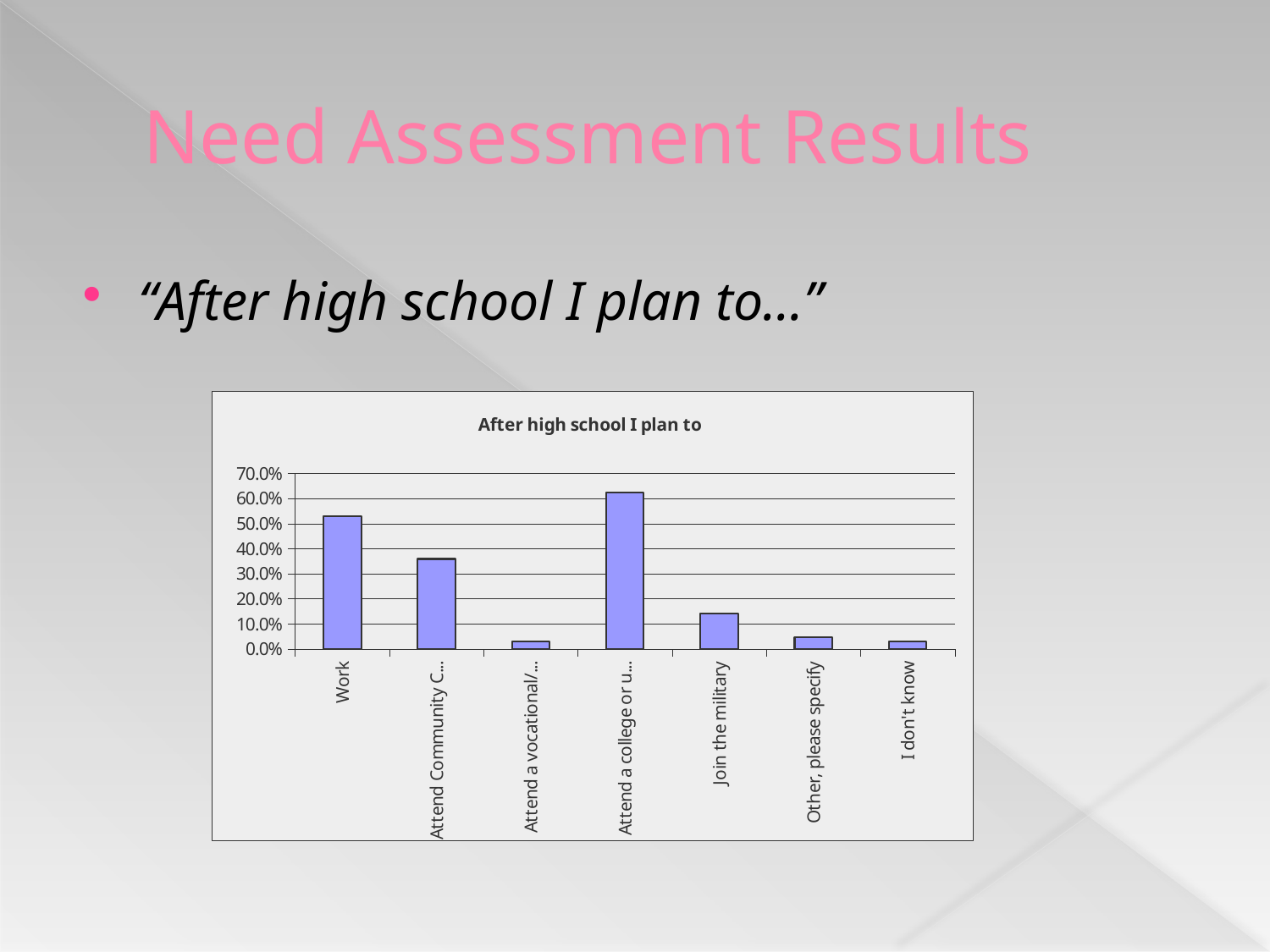
Is the value for Attend Community C... greater or less than 40.0%? less Is the value for Other, please specify greater or less than 10.0%? less Is the value for Join the military greater or less than 20.0%? less Which category has the highest value in the chart? Attend a college or u... What is the title of the chart? After high school I plan to Which is larger, the value for Work or the value for Attend Community C...? Work What kind of chart is shown on the slide? bar chart What is the highest value shown on the vertical axis of the chart? 70.0% How many categories are plotted in the chart? 7 Which is larger, the value for Join the military or the value for I don't know? Join the military